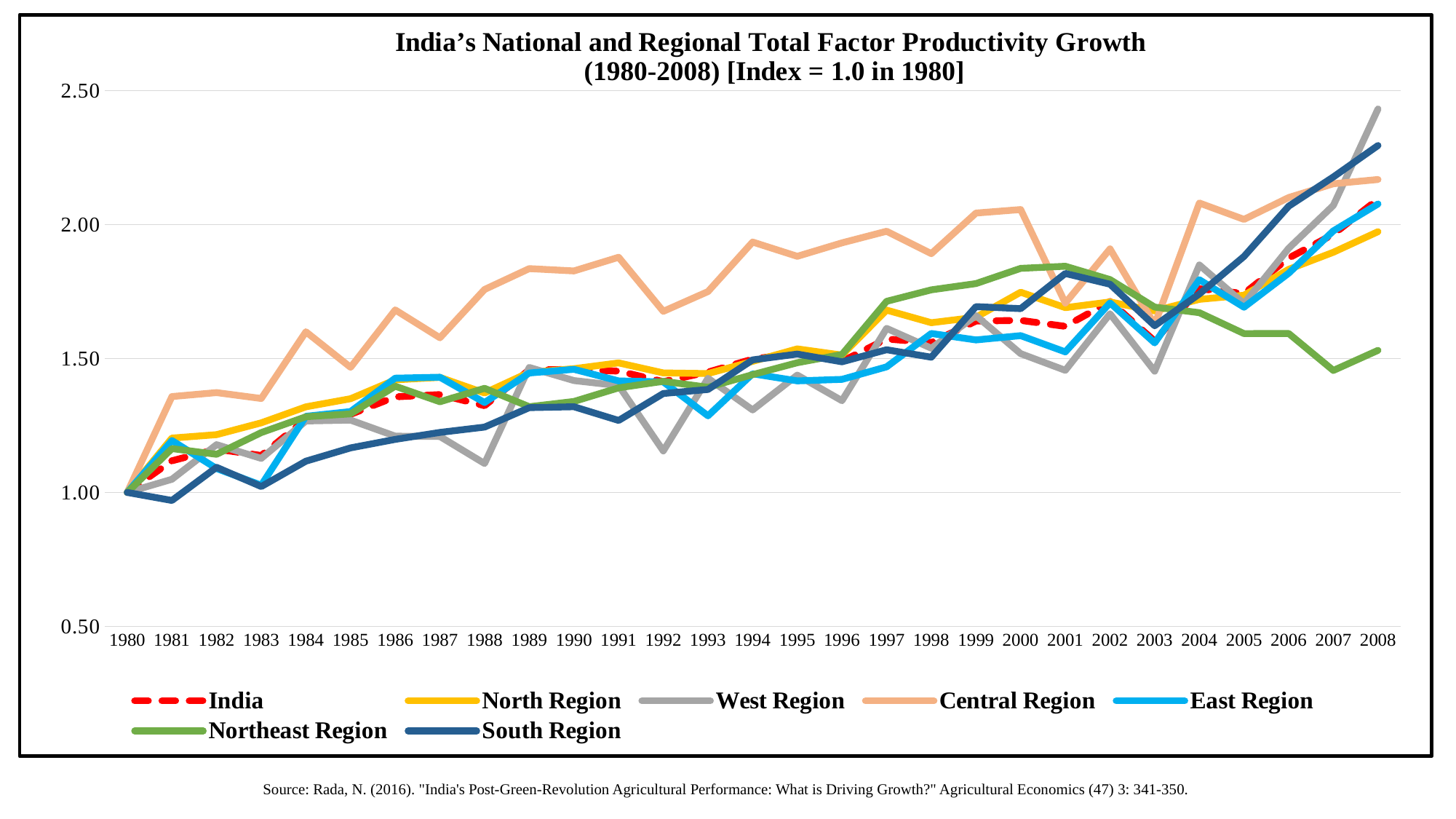
Which region has the lowest index value in 2008? Northeast Region Which series has the highest value in 1990? Central Region Does the India series generally rise or fall from 1980 to 2008? rise Which region has the highest index value in 2008? West Region What kind of chart is shown on the slide? line chart Which series is drawn as a red dashed line? India Is the value for the Northeast Region in 2008 greater or less than 2.00? less Is the value for the Central Region in 2000 greater or less than 2.00? greater What is the index value for India in 1980? 1.00 How many series does the legend list? 7 How many years are plotted along the x axis? 29 In 1990, which is larger: the Central Region or the South Region? Central Region